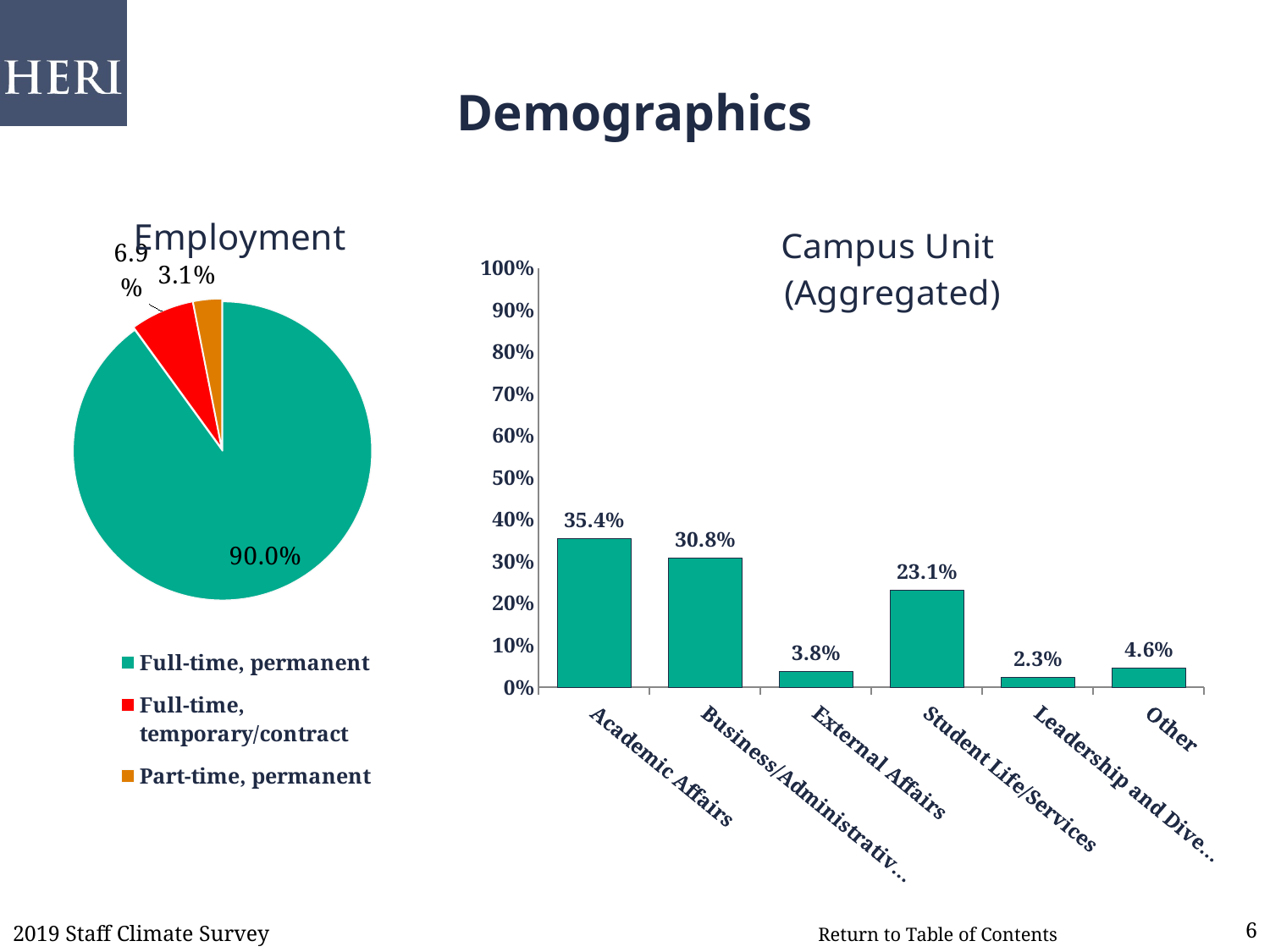
In the Campus Unit (Aggregated) chart, what is the value for External Affairs? 3.8% In the Campus Unit (Aggregated) chart, which category has the lowest value? Leadership and Dive... In the Campus Unit (Aggregated) chart, what is the difference between Academic Affairs and Business/Administrative? 4.6 percentage points In the Employment pie chart, what share is Full-time, permanent? 90.0% How many entries does the legend of the Employment pie chart list? 3 In the Campus Unit (Aggregated) chart, how many categories are shown? 6 What kind of chart is the Campus Unit (Aggregated) chart? Bar chart In the Campus Unit (Aggregated) chart, what is the value for Academic Affairs? 35.4% In the Campus Unit (Aggregated) chart, which category has the highest value? Academic Affairs In the Campus Unit (Aggregated) chart, which is larger, Other or External Affairs? Other In the Campus Unit (Aggregated) chart, what is the value for Student Life/Services? 23.1% In the Employment pie chart, what share is Part-time, permanent? 3.1%